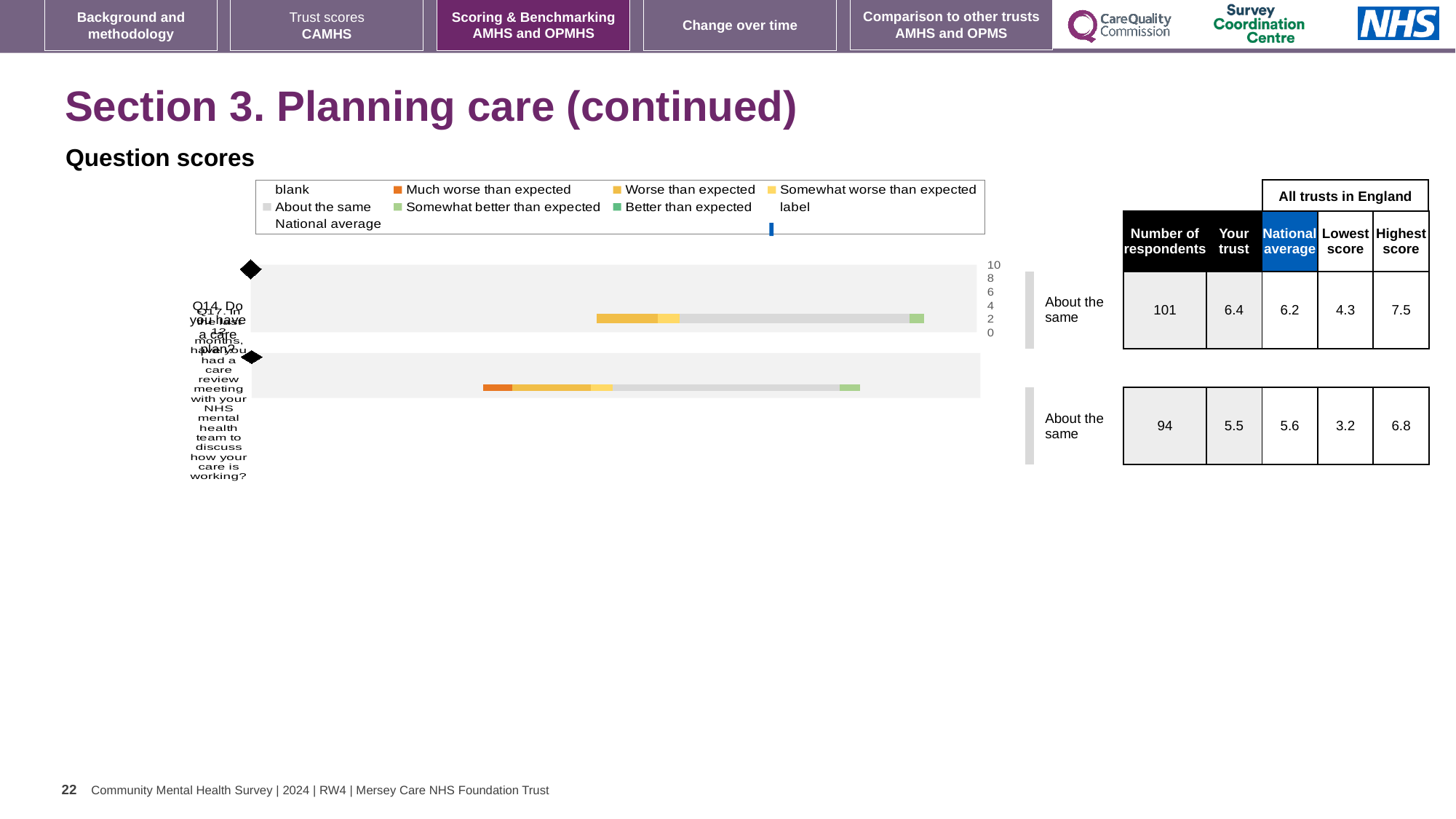
In the table beside the chart, what is the 'Your trust' score for Q14 (Do you have a care plan?)? 6.4 Which question has the higher 'Your trust' score, Q14 or Q17? Q14 What colour does the legend use for 'Much worse than expected'? orange What is the highest tick value shown on the chart's score axis? 10 How many survey questions (bars) are plotted in the chart? 2 In the table beside the chart, how many respondents answered Q17 (care review meeting)? 94 For Q14, what is the difference between the highest score and the lowest score across all trusts in England? 3.2 For Q14, which is larger: the 'Your trust' score or the national average? Your trust What kind of chart is shown under 'Question scores'? bar chart In the table beside the chart, what is the national average for Q17 (care review meeting)? 5.6 What benchmark category is shown next to the bar for Q17? About the same For Q17, what is the difference between the highest score and the lowest score across all trusts in England? 3.6